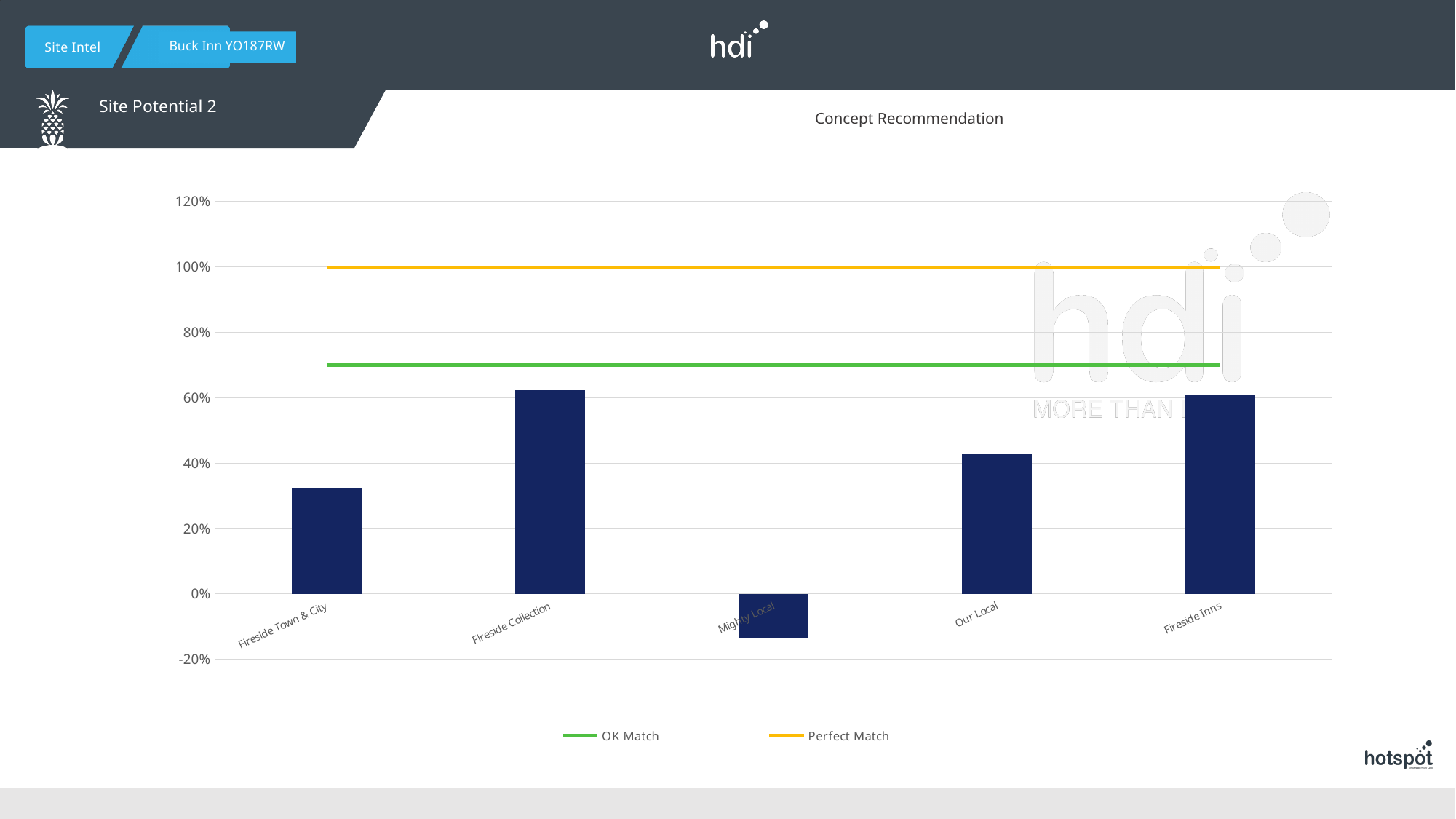
What colour is the OK Match line in the chart? green Is the value for Fireside Town & City greater or less than 40%? less Is the value for Fireside Collection greater or less than 80%? less Which is larger, the value for Our Local or the value for Fireside Town & City? Our Local Which category has the lowest value in the chart? Mighty Local How many categories are plotted along the x axis of the chart? 5 What kind of chart is shown on the slide? bar chart How many entries does the chart's legend list? 2 Is the value for Mighty Local greater or less than 0%? less At what level does the Perfect Match line sit on the chart? 100%